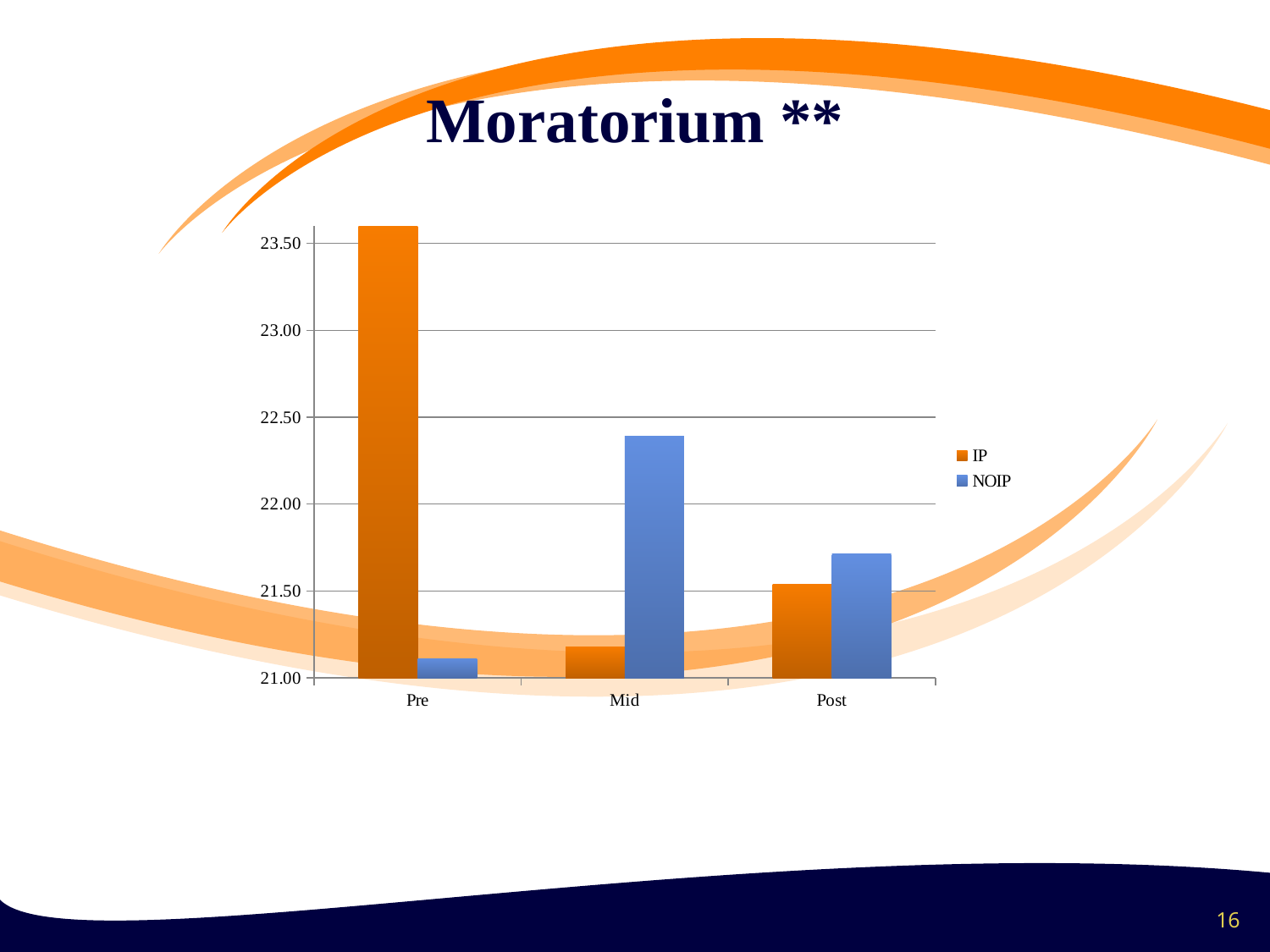
Which category has the lowest NOIP value? Pre What is the title of the chart? Moratorium ** In the Mid category, which series has the larger value, IP or NOIP? NOIP How many categories are shown on the x axis? 3 How many series does the legend list? 2 Does the IP series rise or fall from Pre to Mid? fall Which category has the highest IP value? Pre Is the IP value for Pre greater or less than 23.00? greater In the Pre category, which series has the larger value, IP or NOIP? IP What kind of chart is shown on the slide? bar chart Which category has the highest NOIP value? Mid Which category has the lowest IP value? Mid